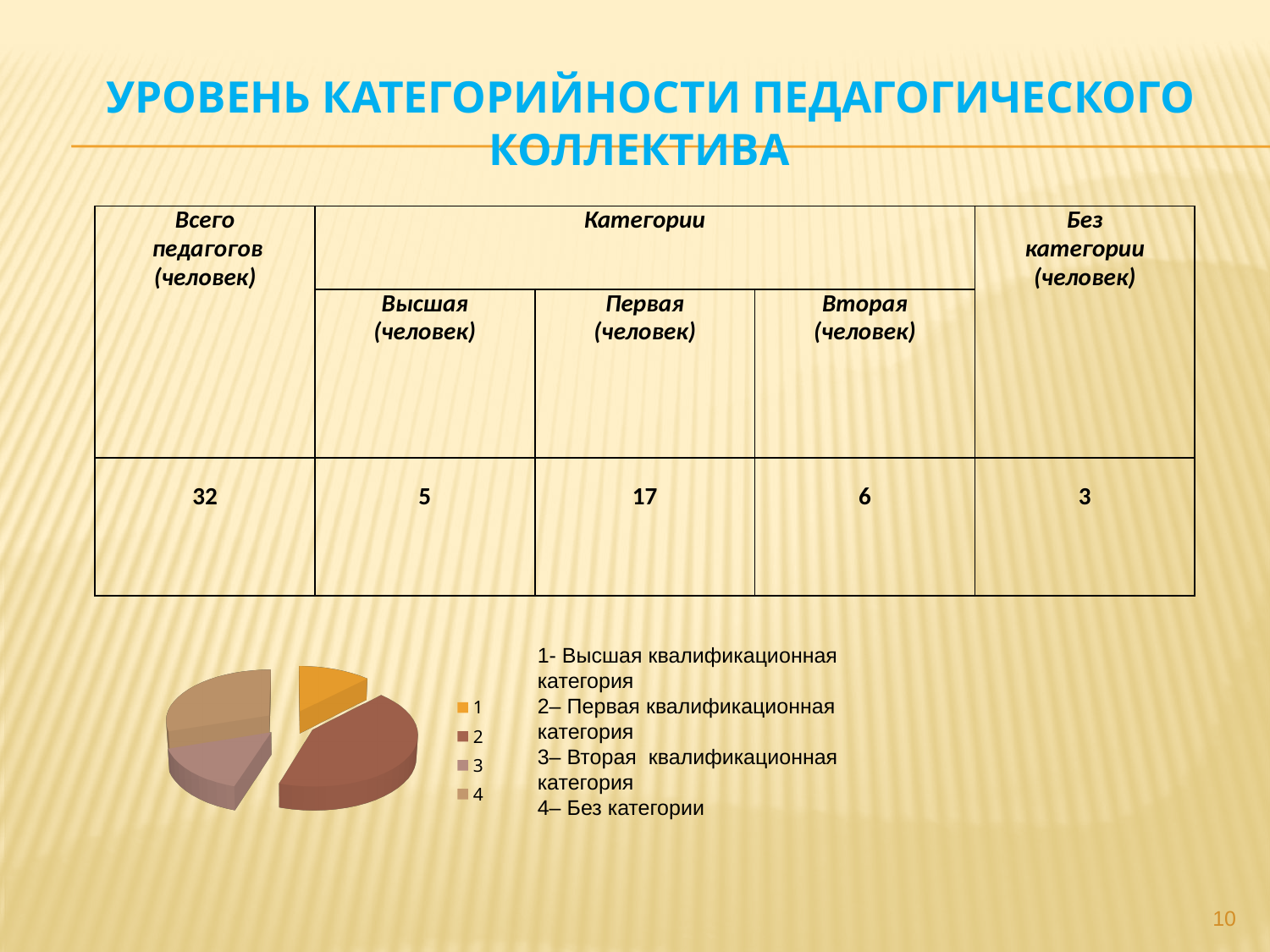
How many entries does the pie chart's legend list? 4 Which legend entry corresponds to the largest slice of the pie chart? 2 According to the key next to the pie chart, what does legend entry 1 stand for? Высшая квалификационная категория How many slices does the pie chart have? 4 Which slice is larger in the pie chart, slice 2 or slice 3? 2 According to the key next to the pie chart, what does legend entry 4 stand for? Без категории Which slice is larger in the pie chart, slice 2 or slice 1? 2 What kind of chart is shown on the slide? pie chart